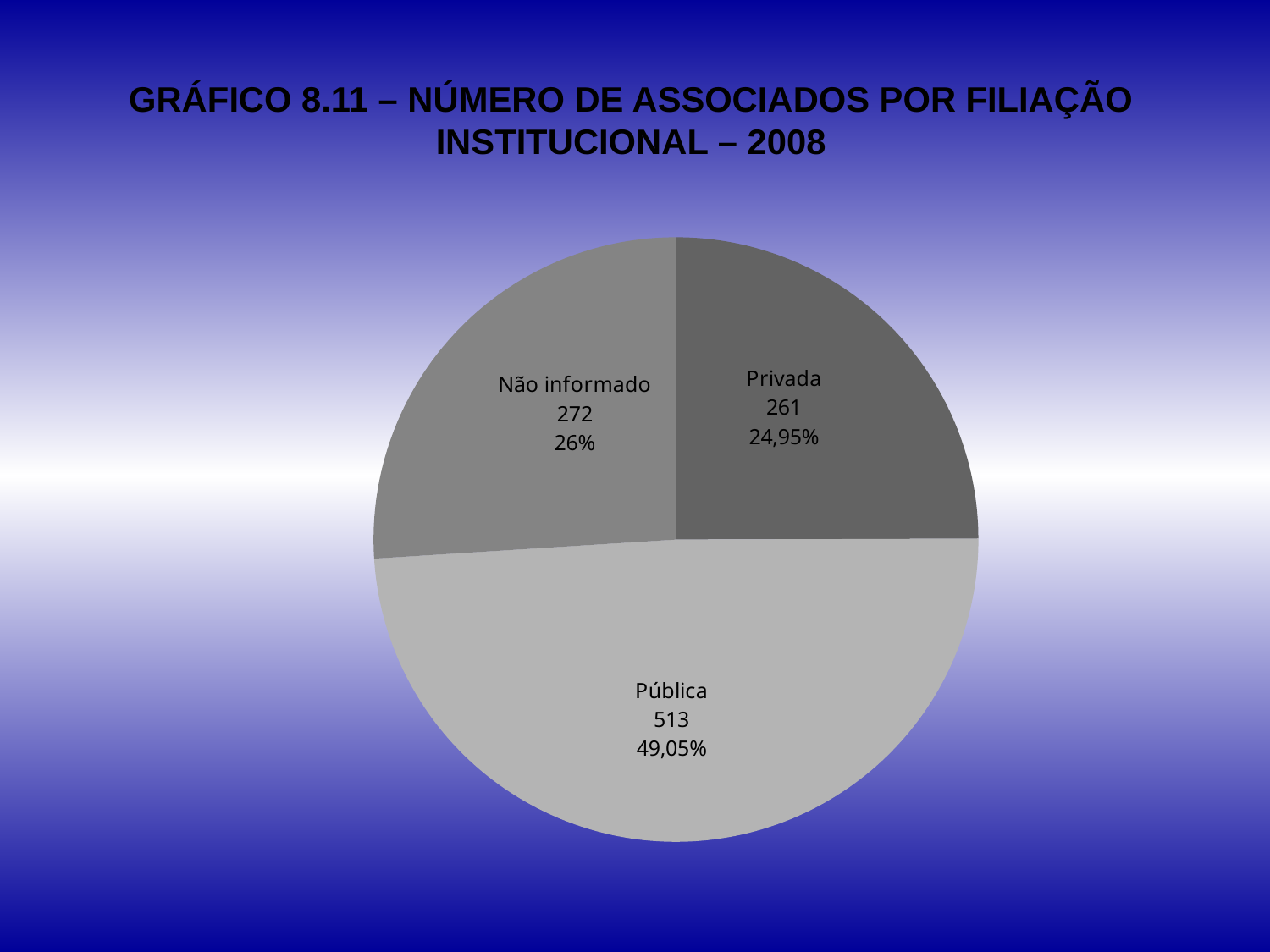
Which category has the largest slice? Pública Which is larger, the value for Não informado or the value for Privada? Não informado What share of the pie does Privada represent? 24,95% What kind of chart is shown on the slide? pie chart What is the number of associates for Pública? 513 Which category has the smallest slice? Privada How many slices does the pie chart have? 3 What is the difference between the values for Pública and Privada? 252 What is the number of associates for Privada? 261 What is the number of associates for Não informado? 272 What is the title of the chart? GRÁFICO 8.11 – NÚMERO DE ASSOCIADOS POR FILIAÇÃO INSTITUCIONAL – 2008 What share of the pie does Pública represent? 49,05%